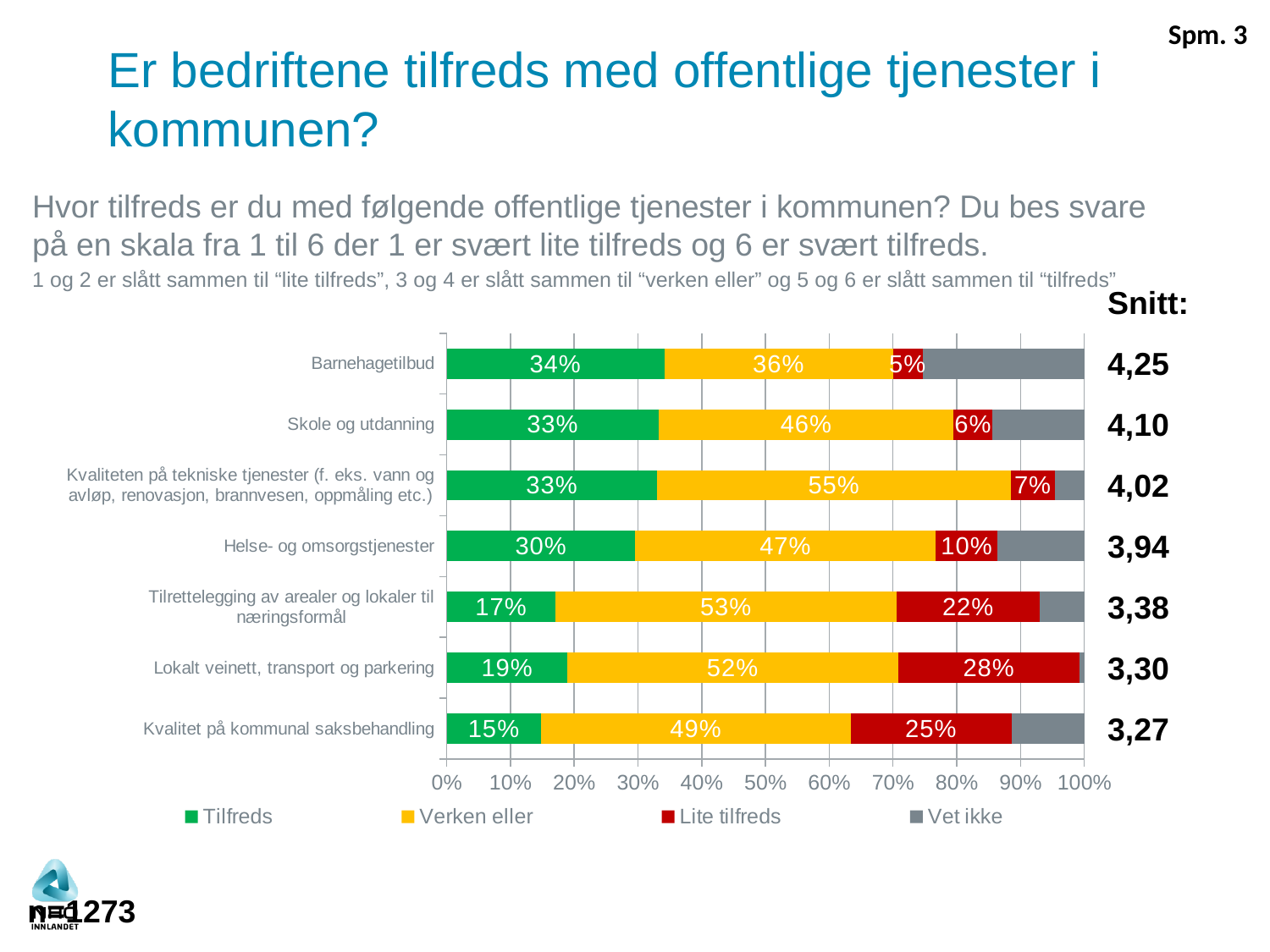
How many categories (public services) are shown in the chart? 7 Which category has the lowest "Tilfreds" share? Kvalitet på kommunal saksbehandling Which category has the highest "Tilfreds" share? Barnehagetilbud Which category has the highest "Lite tilfreds" share? Lokalt veinett, transport og parkering What kind of chart is shown on the slide? Stacked bar chart How many series does the legend list? 4 What is the Snitt (average) value shown for Helse- og omsorgstjenester? 3,94 What is the "Lite tilfreds" share for Lokalt veinett, transport og parkering? 28% What is the difference in percentage points between the "Tilfreds" share for Barnehagetilbud and for Helse- og omsorgstjenester? 4 percentage points What is the "Verken eller" share for Kvaliteten på tekniske tjenester? 55% Which has a larger "Lite tilfreds" share: Tilrettelegging av arealer og lokaler til næringsformål or Kvalitet på kommunal saksbehandling? Kvalitet på kommunal saksbehandling What percentage of respondents answered "Tilfreds" for Barnehagetilbud? 34%